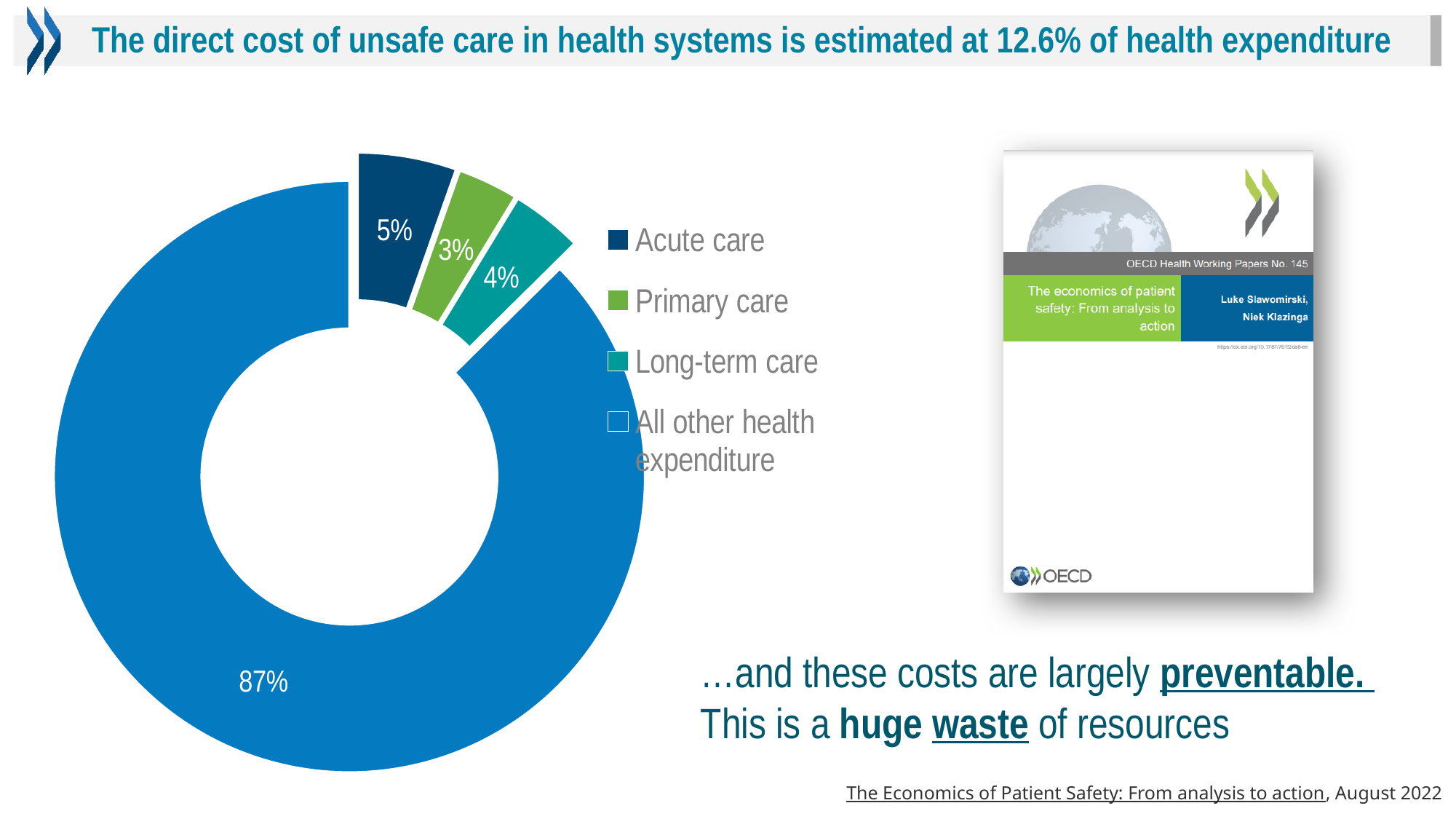
What share of the pie chart is labelled for Long-term care? 4% What is the difference in percentage points between the Acute care slice and the Primary care slice? 2 What colour is the Long-term care slice in the pie chart? Teal Which slice is larger, Acute care or Long-term care? Acute care What share of the pie chart is labelled for Acute care? 5% Which category has the largest slice in the pie chart? All other health expenditure How many categories does the pie chart show? 4 What kind of chart is shown on the slide? Pie chart (doughnut) What share of the pie chart is labelled for All other health expenditure? 87% Which category has the smallest slice in the pie chart? Primary care What share of the pie chart is labelled for Primary care? 3% What is the combined share of Acute care, Primary care and Long-term care in the pie chart? 12%